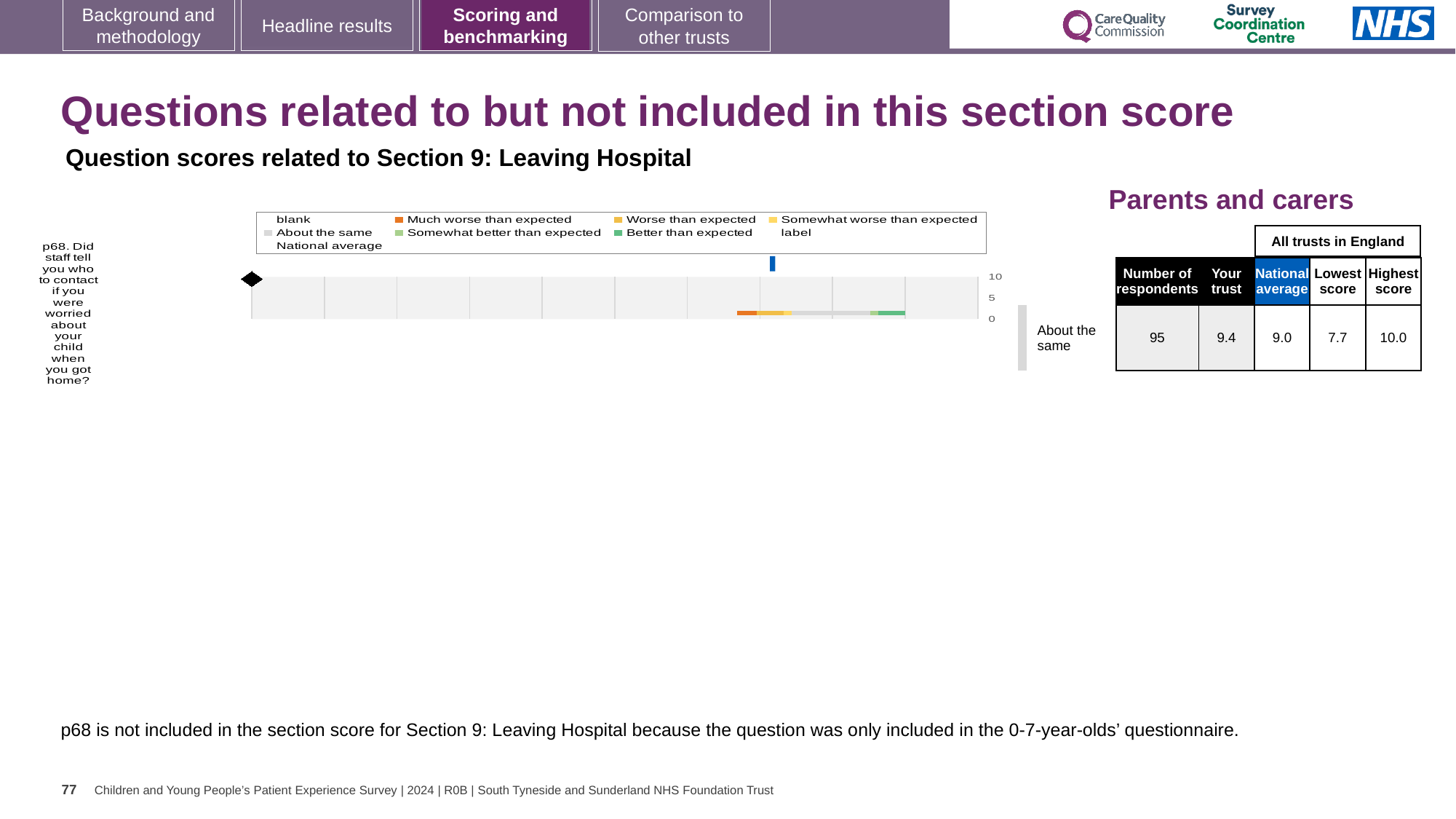
In the table beside the chart, what is the Lowest score among all trusts in England for p68? 7.7 Which is larger for p68, the 'Your trust' score or the National average? Your trust In the table beside the chart, what is the National average score for p68? 9.0 In the table beside the chart, how many respondents answered p68? 95 Which question number is plotted in the chart? p68 In the table beside the chart, what is the 'Your trust' score for p68? 9.4 How many question categories are plotted in the chart? 1 What is the highest tick value shown on the chart's axis? 10 In the table beside the chart, what is the Highest score among all trusts in England for p68? 10.0 What colour does the legend use for 'Much worse than expected'? orange How many entries does the chart's legend list? 9 What kind of chart is shown on the slide? bar chart